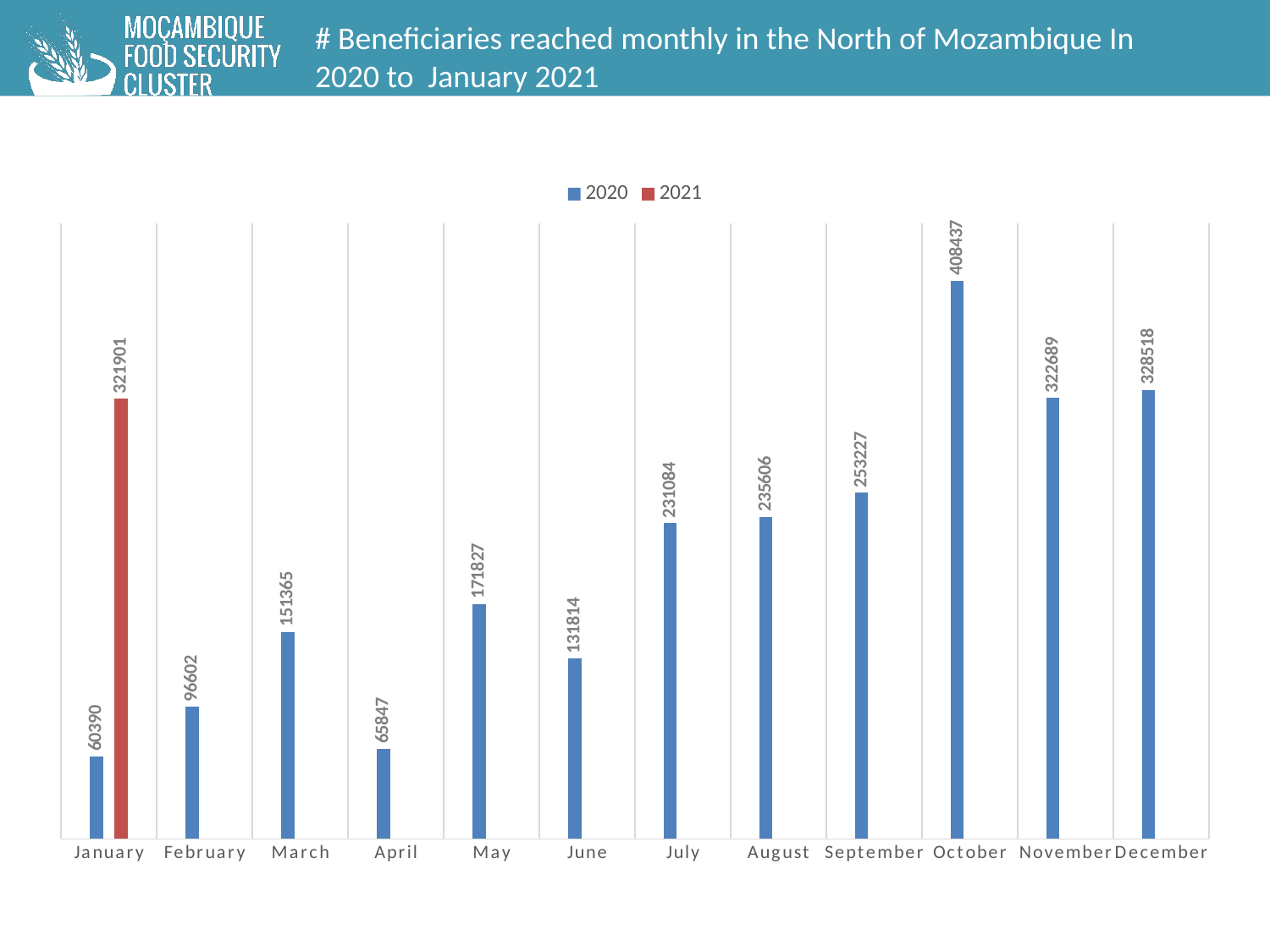
How many series does the legend list? 2 How many months are shown on the x axis? 12 What is the difference between the 2020 values for September and August? 17621 What is the value for January 2020? 60390 How many beneficiaries were reached in October 2020? 408437 What kind of chart is shown on the slide? Bar chart Which colour represents the 2021 series in the legend? Red What is the value for January 2021? 321901 What is the difference between the January 2021 value and the January 2020 value? 261511 Which month has the lowest value for 2020? January Which is larger, the 2020 value for November or for December? December Which month has the highest value for 2020? October